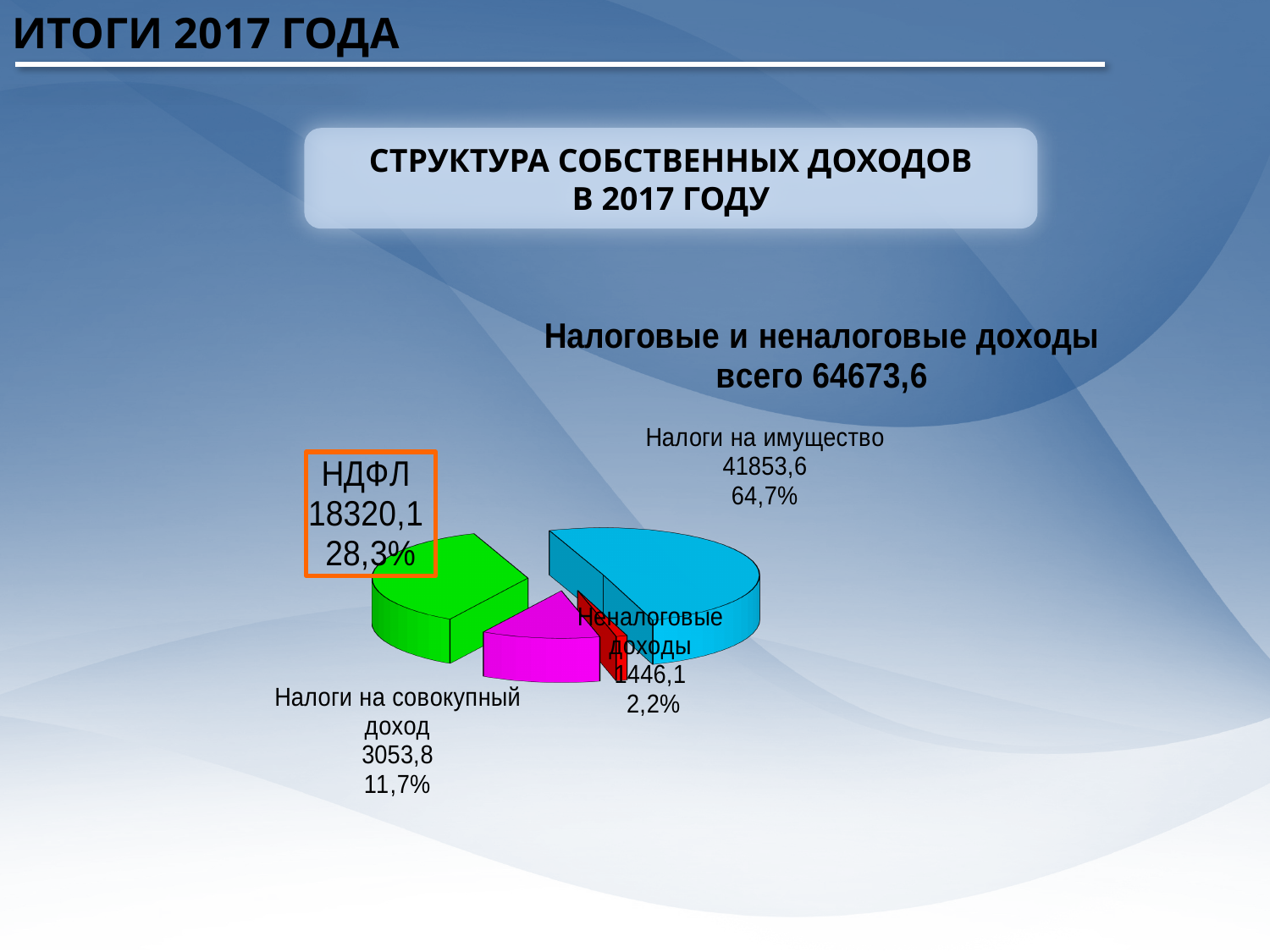
Which category has the largest slice of the pie? Налоги на имущество What is the value for Налоги на совокупный доход? 3053,8 What is the difference between the values for Налоги на имущество and НДФЛ? 23533,5 What is the value for НДФЛ? 18320,1 What is the value for Неналоговые доходы? 1446,1 How many slices does the pie chart have? 4 Which is larger, the value for НДФЛ or the value for Налоги на совокупный доход? НДФЛ What kind of chart is shown on the slide? Pie chart What is the value for Налоги на имущество? 41853,6 What share of the pie does Налоги на имущество represent? 64,7% What share of the pie does Неналоговые доходы represent? 2,2% Which category has the smallest slice of the pie? Неналоговые доходы